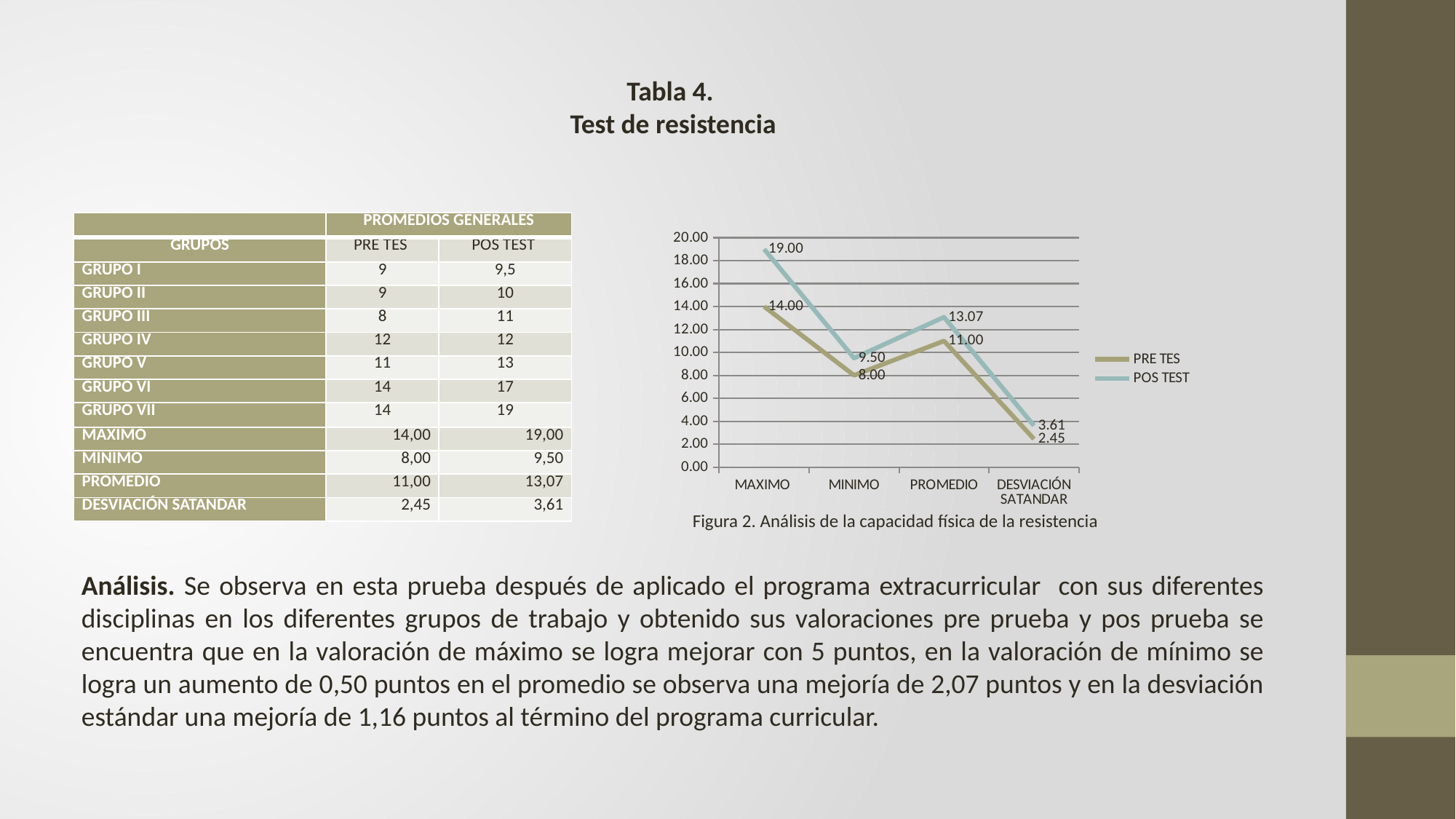
Which category has the highest POS TEST value in the chart? MAXIMO What is the caption of the figure below the chart? Figura 2. Análisis de la capacidad física de la resistencia What is the PRE TES value for MAXIMO in the chart? 14.00 What is the POS TEST value for MAXIMO in the chart? 19.00 Which is larger for MINIMO in the chart, the PRE TES value or the POS TEST value? POS TEST What is the POS TEST value for MINIMO in the chart? 9.50 What kind of chart is shown on the slide? Line chart What is the PRE TES value for DESVIACIÓN SATANDAR in the chart? 2.45 Which category has the lowest PRE TES value in the chart? DESVIACIÓN SATANDAR What is the difference between the POS TEST and PRE TES values for PROMEDIO in the chart? 2.07 How many categories are shown on the x axis of the chart? 4 How many series does the chart legend list? 2